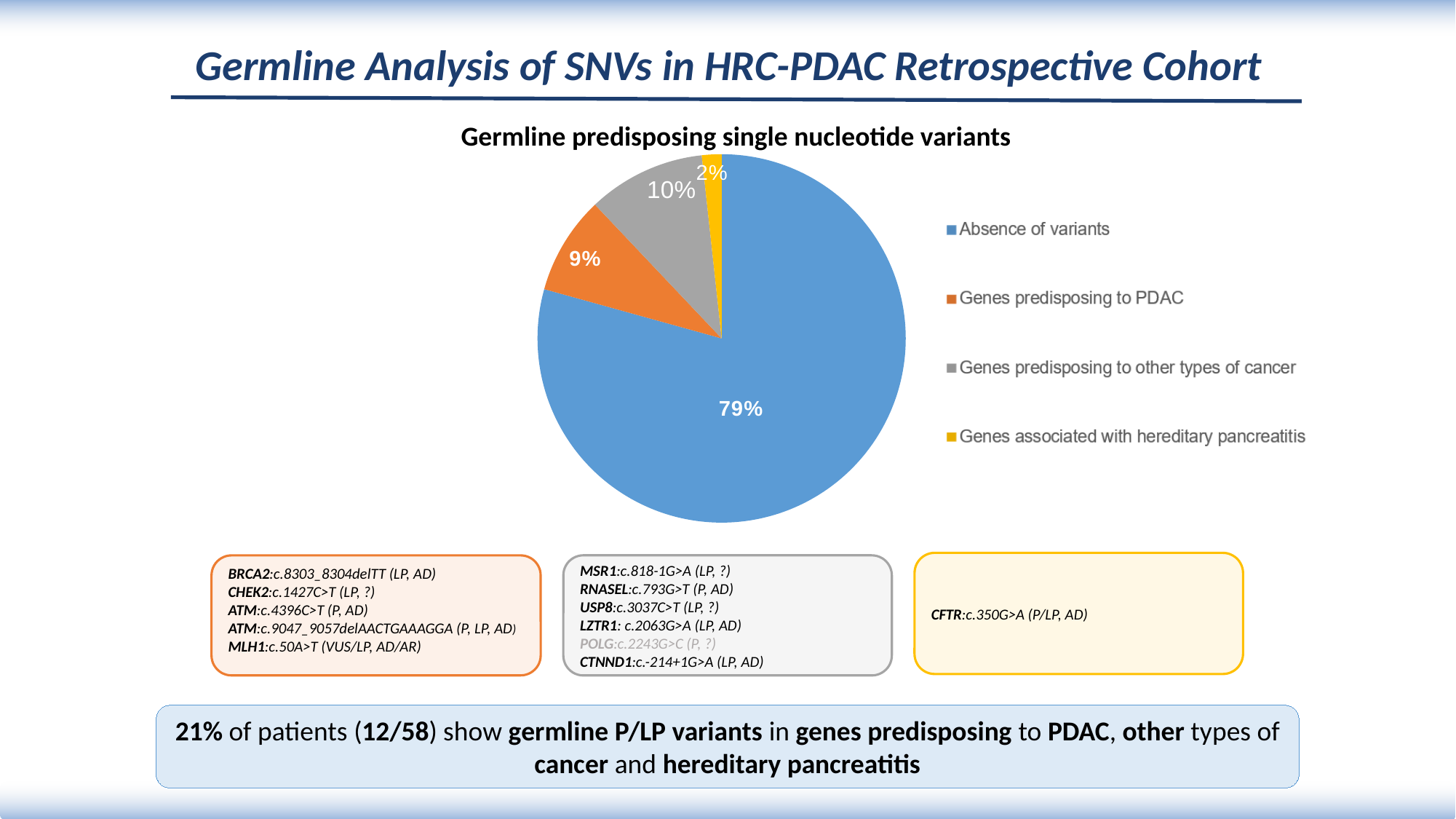
What percentage of the pie is labelled 'Genes predisposing to other types of cancer'? 10% What is the title of the chart? Germline predisposing single nucleotide variants What is the difference in percentage points between 'Absence of variants' and 'Genes predisposing to other types of cancer'? 69 Which slice is larger: 'Genes predisposing to PDAC' or 'Genes associated with hereditary pancreatitis'? Genes predisposing to PDAC What percentage of the pie is labelled 'Absence of variants'? 79% What colour is the slice for 'Genes predisposing to PDAC'? Orange What kind of chart is shown on the slide? Pie chart What percentage of the pie is labelled 'Genes predisposing to PDAC'? 9% What percentage of the pie is labelled 'Genes associated with hereditary pancreatitis'? 2% Which category has the smallest slice of the pie? Genes associated with hereditary pancreatitis Which category has the largest slice of the pie? Absence of variants How many categories does the legend list? 4